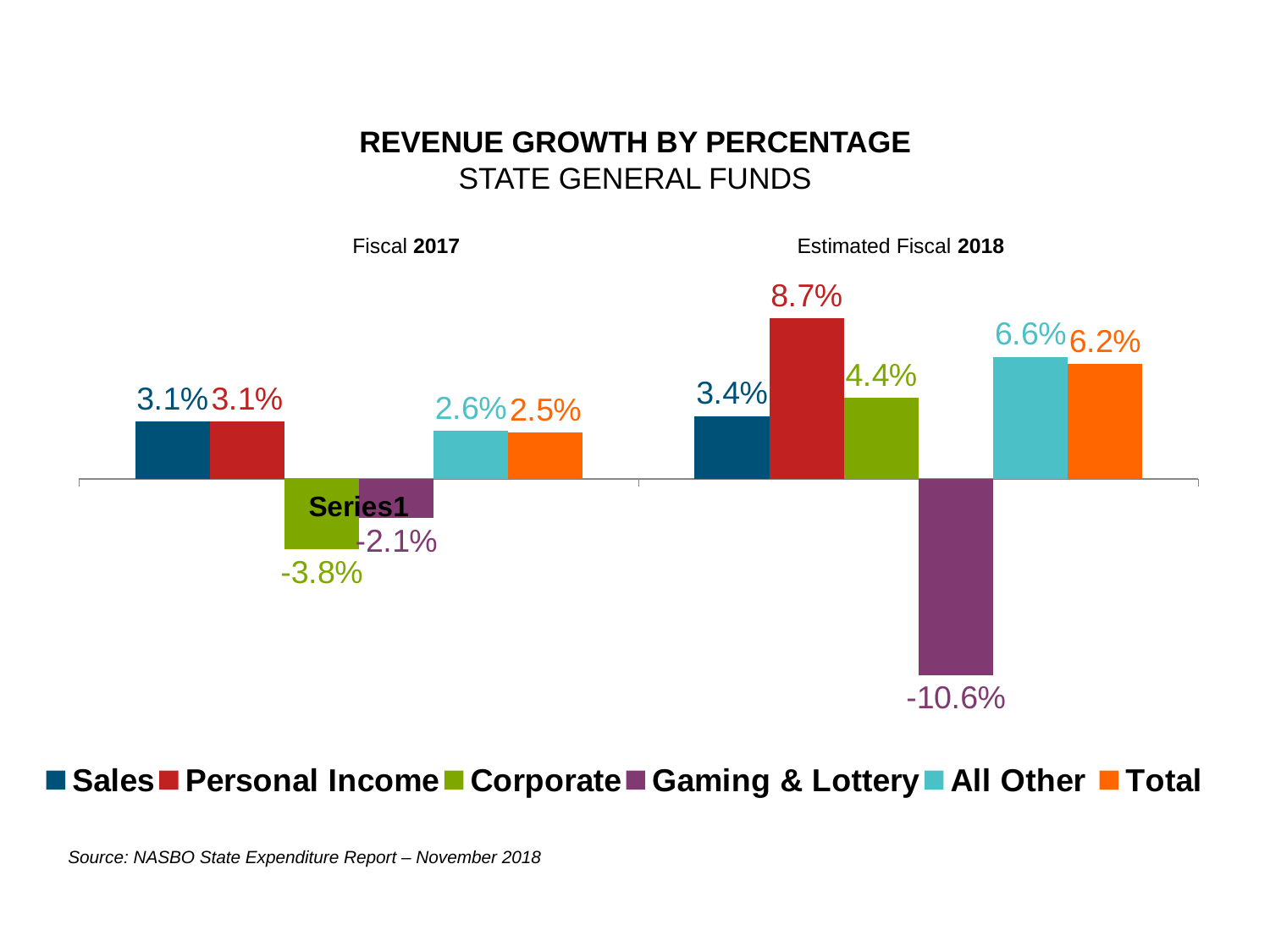
How many series does the legend list? 6 What is the Total revenue growth for Fiscal 2017? 2.5% What is the Personal Income revenue growth for Estimated Fiscal 2018? 8.7% Which series has the highest value in Estimated Fiscal 2018? Personal Income What is the difference between the Personal Income values for Estimated Fiscal 2018 and Fiscal 2017? 5.6% Does the Sales value rise or fall from Fiscal 2017 to Estimated Fiscal 2018? Rise What is the Gaming & Lottery revenue growth for Estimated Fiscal 2018? -10.6% Which is larger: the All Other value for Estimated Fiscal 2018 or the Total value for Estimated Fiscal 2018? All Other What kind of chart is shown on the slide? Bar chart What is the title of the chart? Revenue Growth by Percentage, State General Funds Which series has the lowest value in Fiscal 2017? Corporate What is the Corporate revenue growth for Fiscal 2017? -3.8%